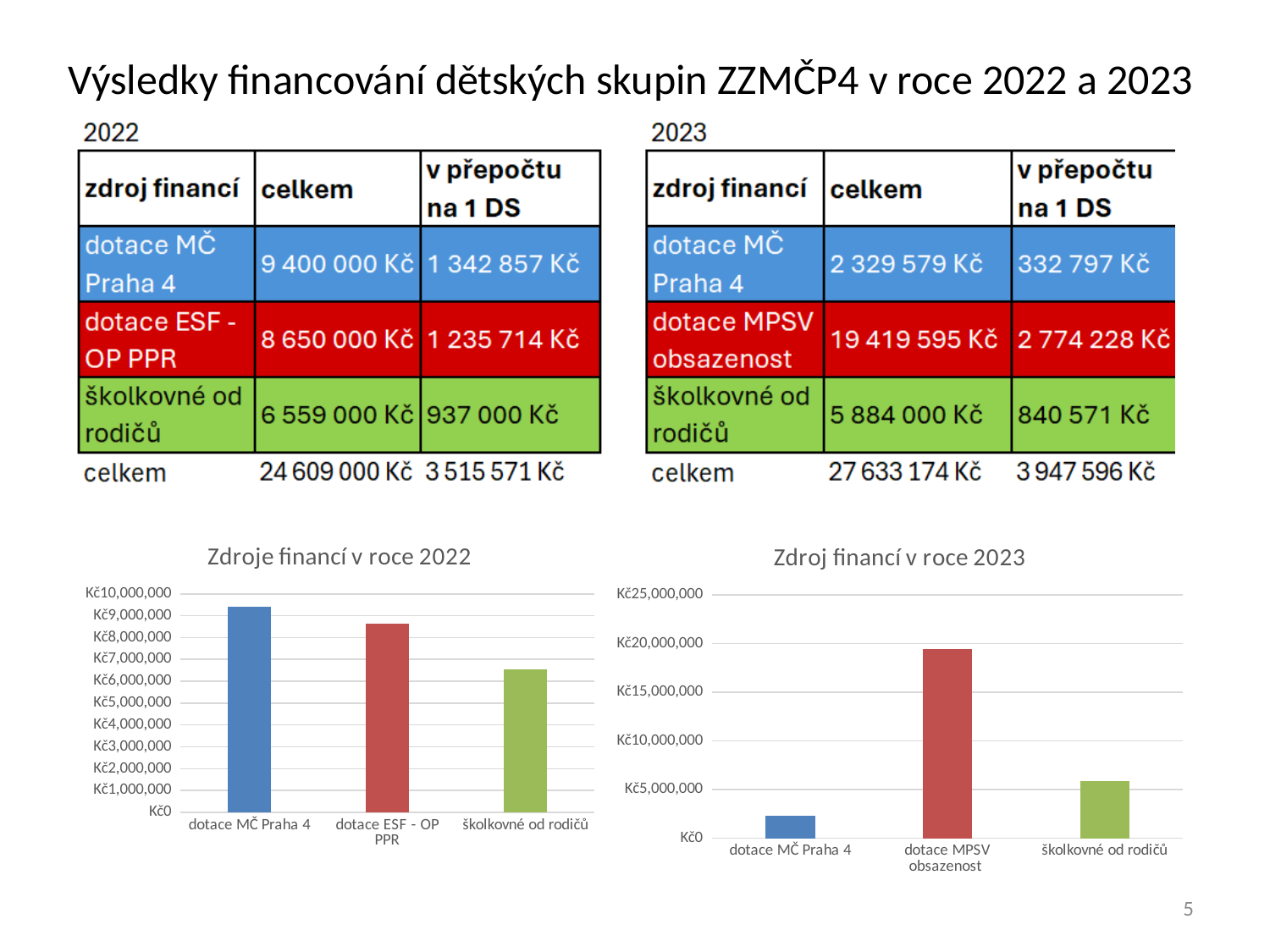
What is the title of the chart on the right side of the slide? Zdroj financí v roce 2023 What kind of chart is "Zdroje financí v roce 2022"? bar chart In the chart "Zdroj financí v roce 2023", which category has the lowest value? dotace MČ Praha 4 In the chart "Zdroj financí v roce 2023", is the value for dotace MČ Praha 4 greater or less than Kč5,000,000? less In the chart "Zdroj financí v roce 2023", which category has the highest value? dotace MPSV obsazenost In the chart "Zdroje financí v roce 2022", which category has the highest value? dotace MČ Praha 4 In the chart "Zdroj financí v roce 2023", which is larger: dotace MČ Praha 4 or školkovné od rodičů? školkovné od rodičů How many categories are shown in the chart "Zdroje financí v roce 2022"? 3 In the chart "Zdroj financí v roce 2023", is the value for dotace MPSV obsazenost greater or less than Kč15,000,000? greater In the chart "Zdroje financí v roce 2022", is the value for dotace ESF - OP PPR greater or less than Kč8,000,000? greater In the chart "Zdroje financí v roce 2022", which category has the lowest value? školkovné od rodičů